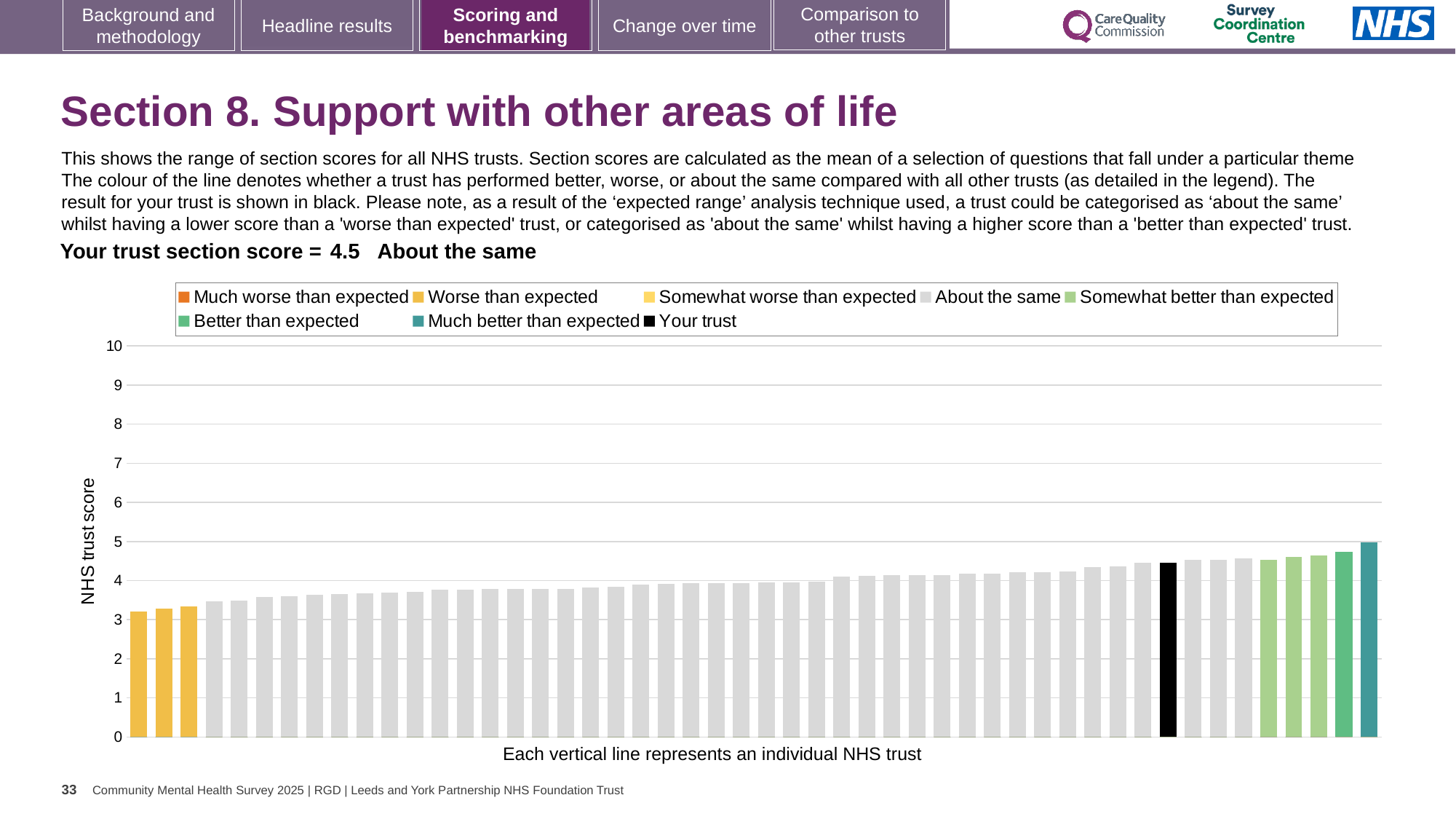
What is the label on the vertical axis of the chart? NHS trust score Is the value of the highest bar in the chart greater or less than 6? less Which legend category do the lowest bars in the chart belong to? Worse than expected How many bars are coloured as 'Worse than expected'? 3 Which category is your trust placed in for this section? About the same Which legend category does the highest bar in the chart belong to? Much better than expected Is the value of the black 'Your trust' bar greater or less than 4? greater Is the value of the lowest bar in the chart greater or less than 4? less Do the bar values rise or fall from left to right along the x axis? Rise How many entries does the chart legend list? 8 What kind of chart is shown on the slide? Bar chart What is the section score for your trust shown on the slide? 4.5